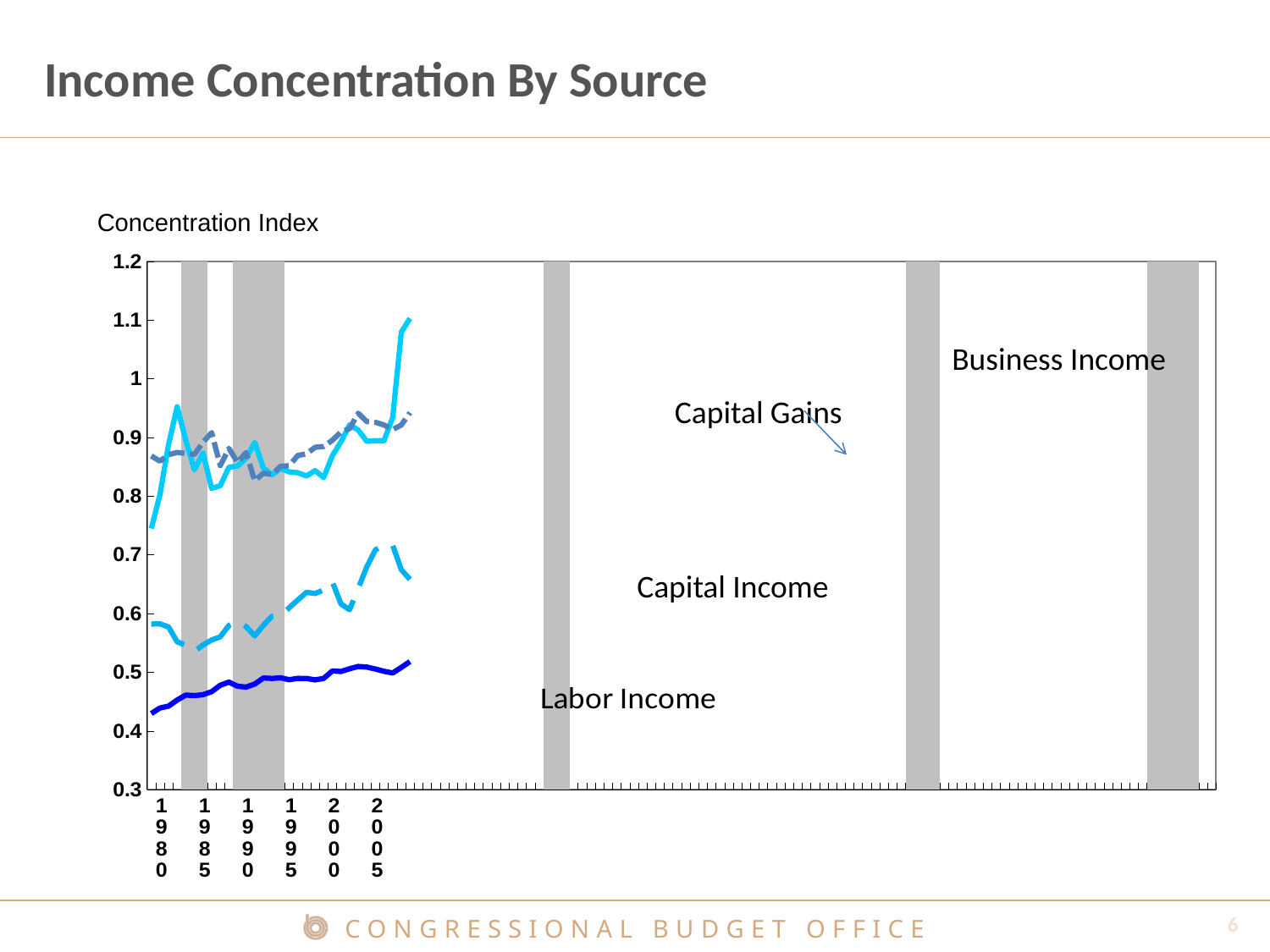
Which series reaches the highest concentration index on the chart? Capital Gains Which series has the lowest concentration index throughout the period shown? Labor Income Is the concentration index for Capital Income in 1985 greater or less than 0.6? less Is the concentration index for Capital Gains at the end of the period greater or less than 1? greater How many income sources (series) are labeled on the chart? 4 Does the Labor Income line generally rise or fall from 1980 to the end of the period? rise What is the first year shown on the horizontal axis? 1980 What kind of chart is shown on the slide? line chart Is the concentration index for Labor Income in 1980 greater or less than 0.5? less What is the title of the chart on the slide? Income Concentration By Source What is the label on the vertical axis of the chart? Concentration Index Which has a higher concentration index in 2005, Capital Income or Labor Income? Capital Income